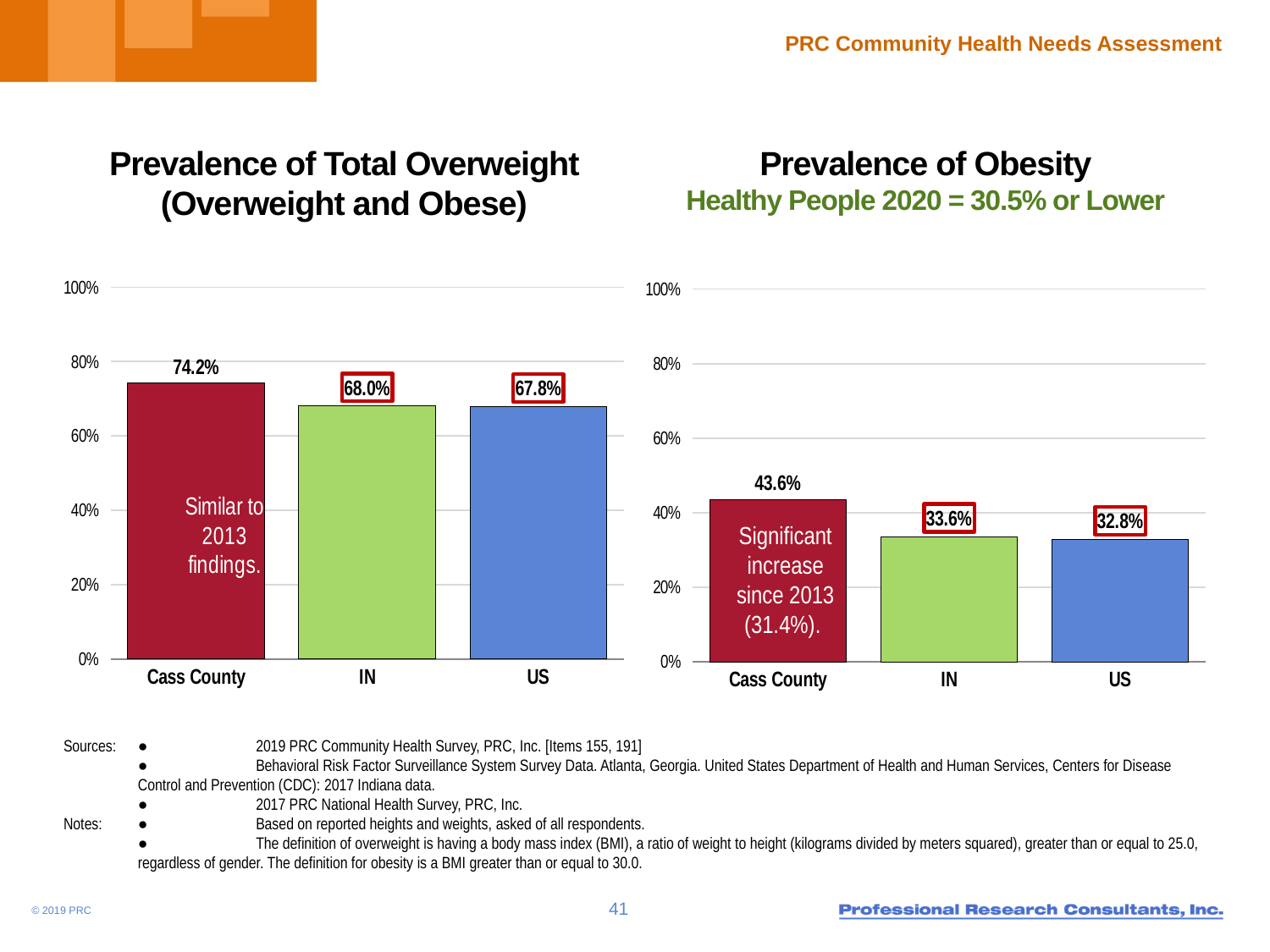
How many categories are shown on the x axis of the 'Prevalence of Obesity' chart? 3 In the 'Prevalence of Total Overweight (Overweight and Obese)' chart, what is the value for IN? 68.0% In the 'Prevalence of Obesity' chart, what is the value for US? 32.8% In the 'Prevalence of Obesity' chart, what is the difference between the Cass County value and the IN value? 10.0% What Healthy People 2020 target is stated in the subtitle of the 'Prevalence of Obesity' chart? 30.5% or Lower In the 'Prevalence of Total Overweight (Overweight and Obese)' chart, what is the value for Cass County? 74.2% In the 'Prevalence of Total Overweight (Overweight and Obese)' chart, which category has the lowest value? US In the 'Prevalence of Obesity' chart, is the value for IN larger or smaller than the value for US? larger In the 'Prevalence of Total Overweight (Overweight and Obese)' chart, what is the difference between the Cass County value and the US value? 6.4% In the 'Prevalence of Obesity' chart, which category has the highest value? Cass County In the 'Prevalence of Obesity' chart, what is the value for Cass County? 43.6% What kind of chart is the 'Prevalence of Total Overweight (Overweight and Obese)' chart? bar chart